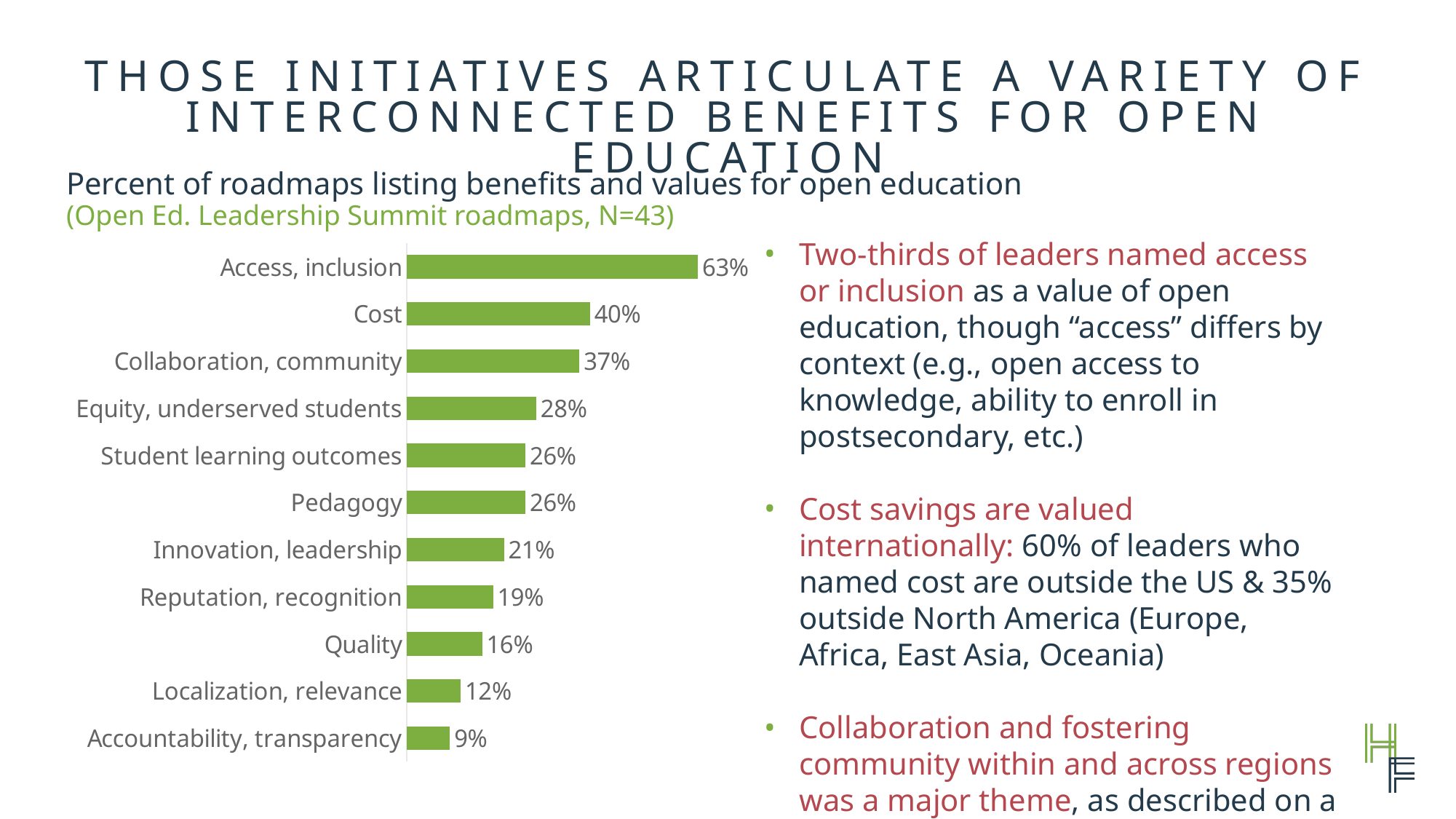
What is the difference between the values for Collaboration, community and Quality? 21% What is the value for Localization, relevance? 12% Which is larger, the value for Innovation, leadership or the value for Reputation, recognition? Innovation, leadership What percent of roadmaps list Equity, underserved students? 28% Which category has the lowest percentage? Accountability, transparency How many categories are shown in the chart? 11 What is the value shown for Cost? 40% What is the difference between the values for Access, inclusion and Cost? 23% What percent of roadmaps list Access, inclusion as a benefit? 63% What is the sample size (N) stated in the chart subtitle? N=43 What kind of chart is shown on the slide? Bar chart Which category has the highest percentage? Access, inclusion